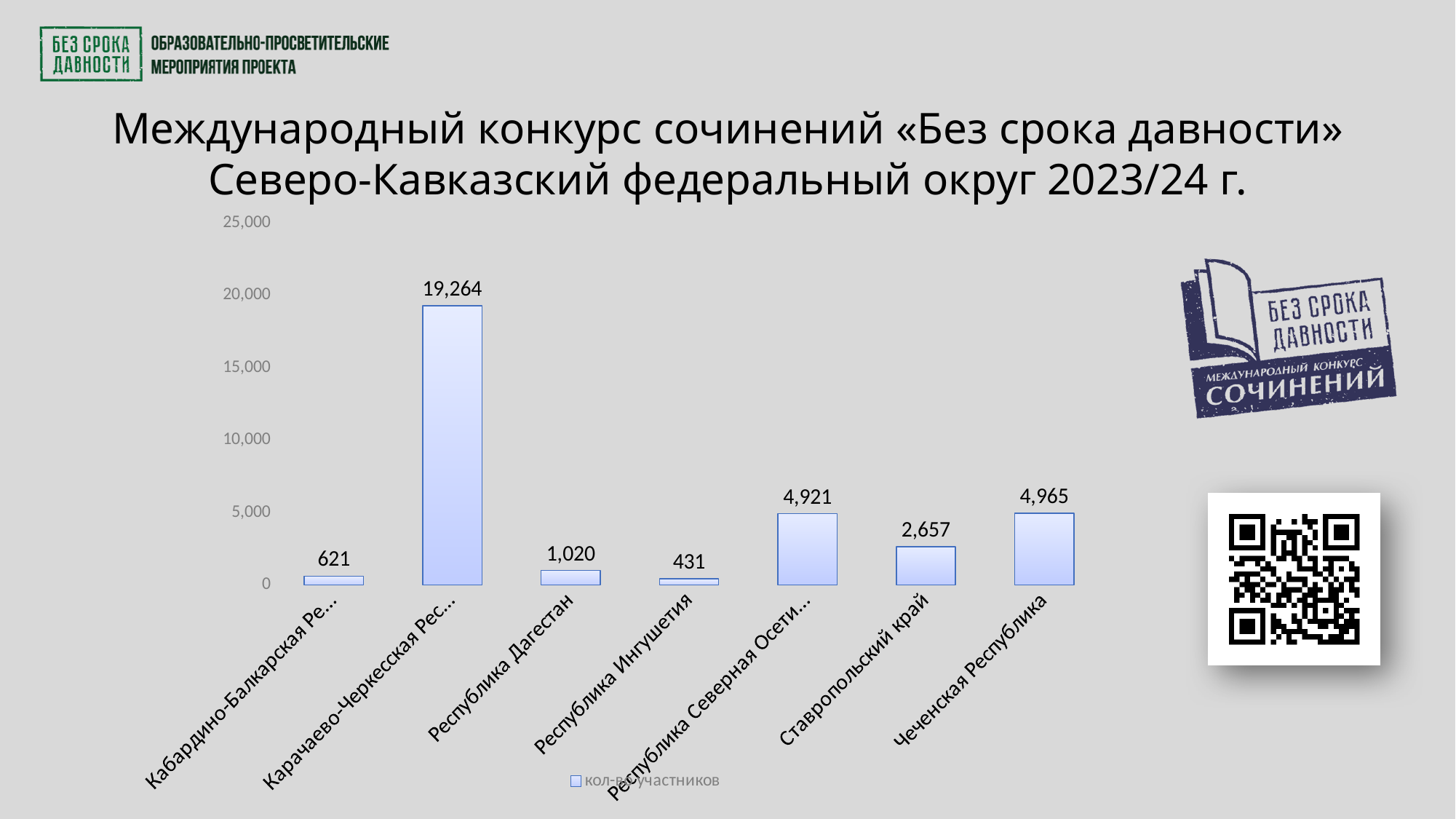
How many regions (categories) are plotted in the chart? 7 What is the value for Республика Ингушетия? 431 Which region has the lowest value in the chart? Республика Ингушетия What is the difference between the values for Чеченская Республика and Республика Северная Осетия? 44 How many series does the legend list? 1 What is the value for Ставропольский край? 2,657 What type of chart is shown on the slide? bar chart Which region has the highest value in the chart? Карачаево-Черкесская Республика What is the value for Республика Дагестан? 1,020 What is the value for Чеченская Республика? 4,965 Which is larger: the value for Ставропольский край or the value for Республика Дагестан? Ставропольский край Is the value for Карачаево-Черкесская Республика greater or less than 15,000? greater